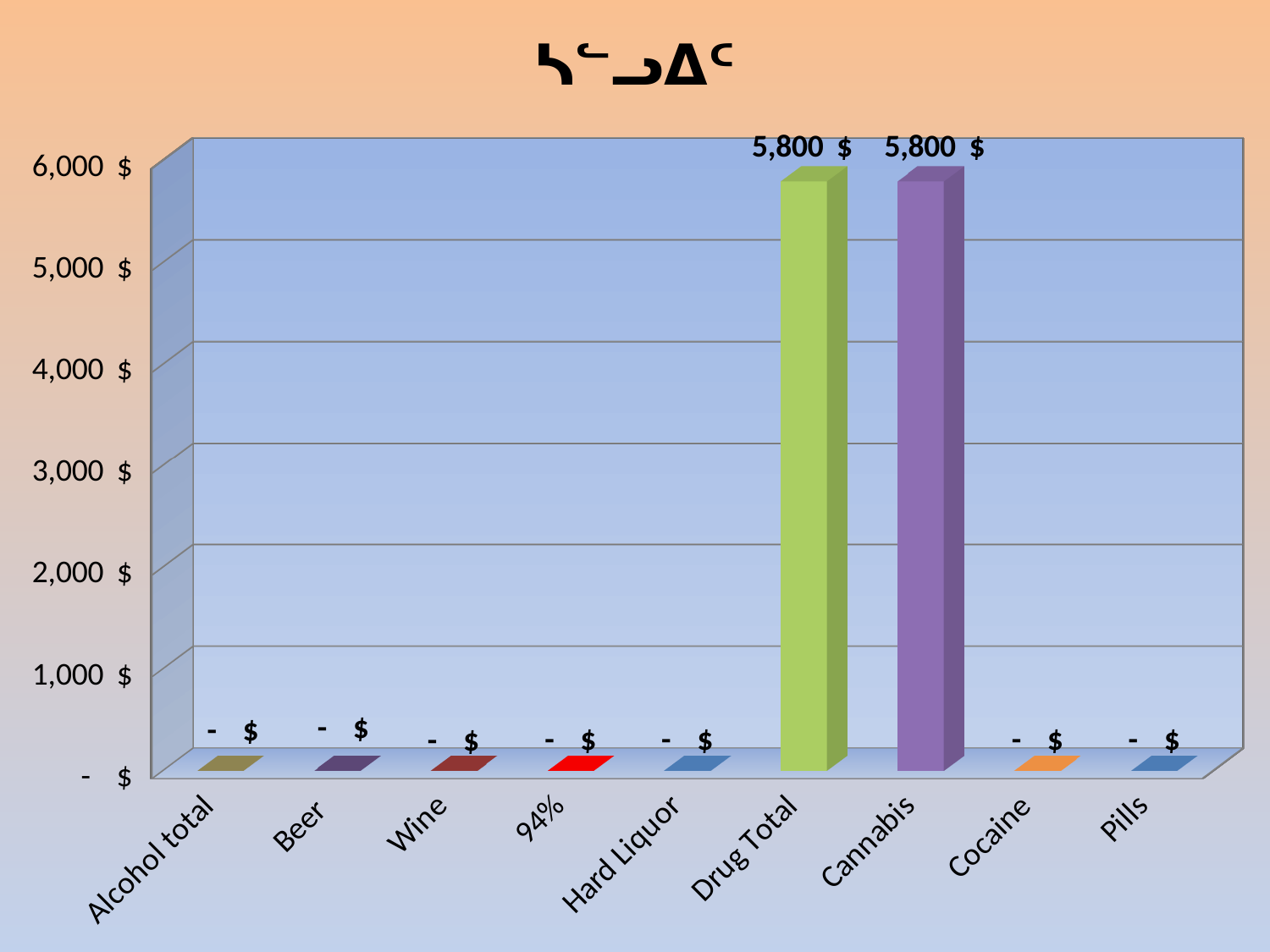
What is the value for Cannabis? 5,800 $ Which two categories share the highest value? Drug Total and Cannabis How many categories are shown on the x axis? 9 What is the difference between the values for Drug Total and Cannabis? 0 $ What is the value for Drug Total? 5,800 $ Which is larger, the value for Cannabis or the value for Cocaine? Cannabis What value is shown for Beer? - $ How many categories have a value other than '- $'? 2 What value is shown for Cocaine? - $ What kind of chart is shown on the slide? Bar chart What colour is the Cannabis bar? Purple Is the value for Cannabis greater or less than 5,000? greater